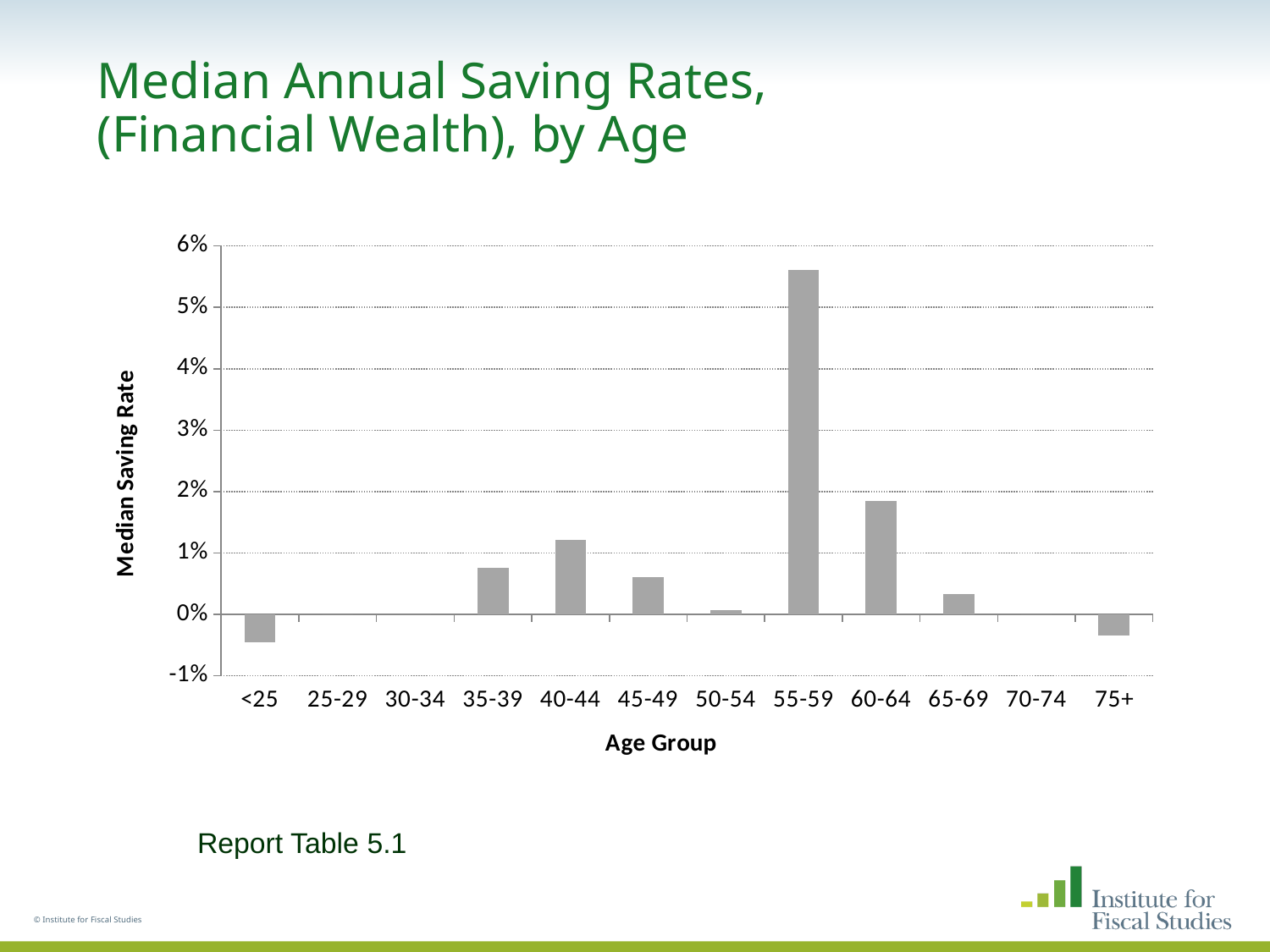
Which has the higher median saving rate, the 60-64 age group or the 65-69 age group? 60-64 Which age group has the highest median saving rate? 55-59 Is the median saving rate for the 55-59 age group greater or less than 5%? greater Is the median saving rate for the 40-44 age group greater or less than 1%? greater How many age groups are shown on the x axis? 12 Is the median saving rate for the <25 age group greater or less than 0%? less What is the label of the y axis? Median Saving Rate What kind of chart is shown on the slide? bar chart What is the label of the x axis? Age Group Which has the higher median saving rate, the 40-44 age group or the 45-49 age group? 40-44